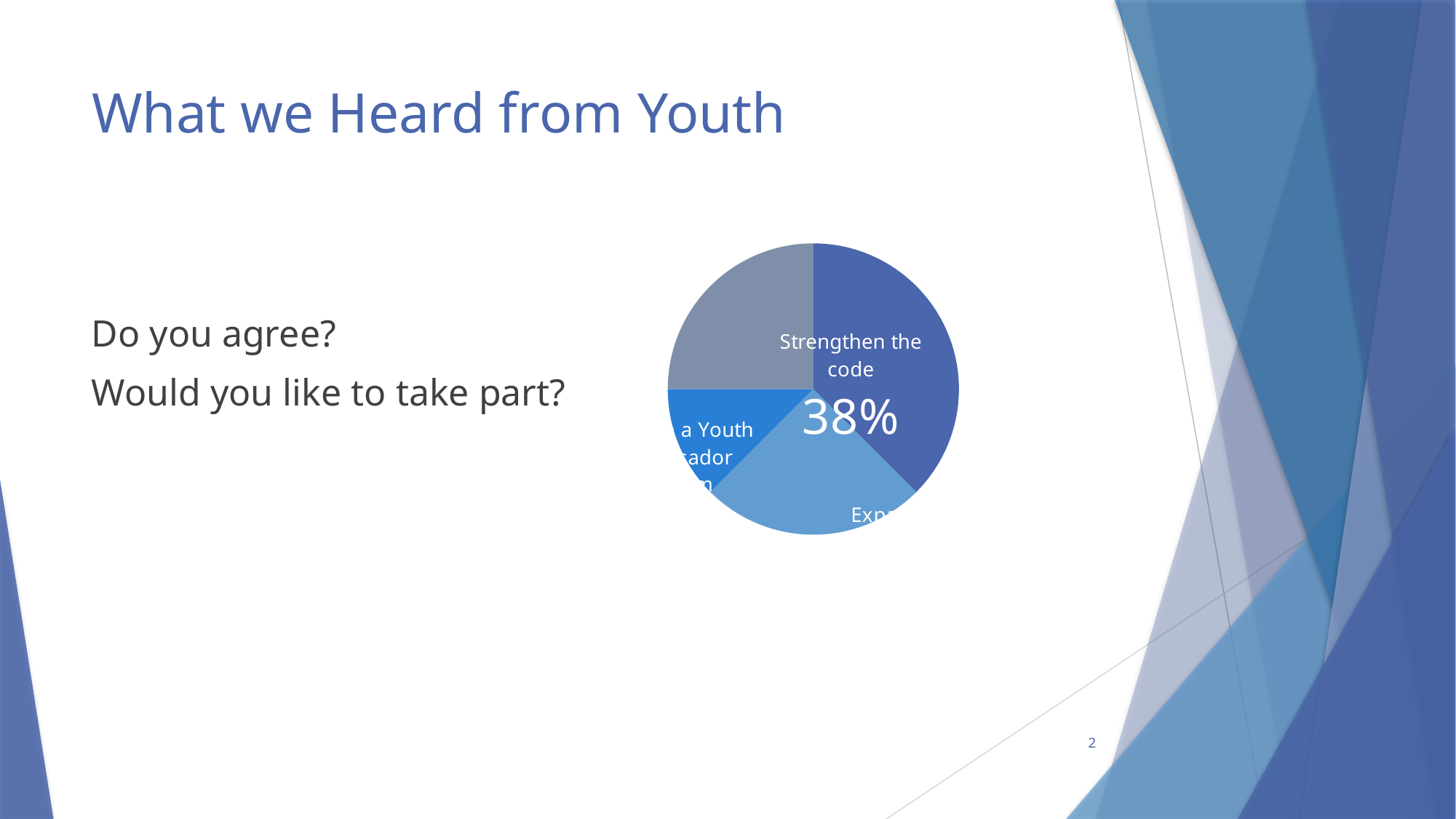
Is the "Strengthen the code" slice more or less than half of the pie? less What share of the pie does the "Strengthen the code" slice represent? 38% What colour is the "Strengthen the code" slice in the pie chart? dark blue What kind of chart is shown on the slide? pie chart Which slice of the pie chart is the largest? Strengthen the code How many slices does the pie chart have? 4